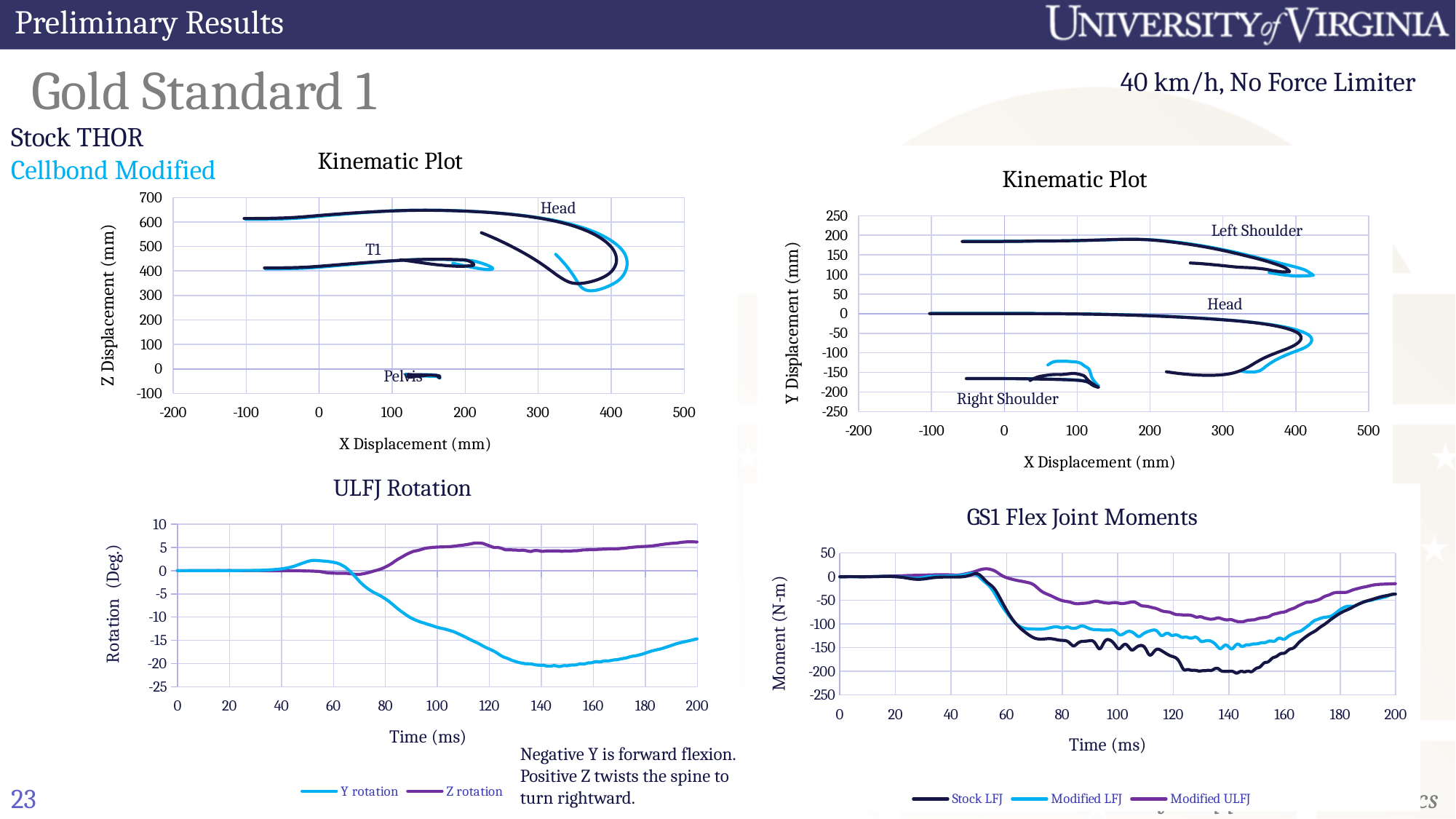
In the ULFJ Rotation chart, does the Y rotation series rise or fall between 80 ms and 140 ms? fall In the ULFJ Rotation chart, is the Y rotation value at 140 ms greater or less than -15? less How many series does the legend of the ULFJ Rotation chart list? 2 In the GS1 Flex Joint Moments chart, which series has the higher value at 140 ms, Modified ULFJ or Stock LFJ? Modified ULFJ What kind of chart is the ULFJ Rotation chart? line chart In the GS1 Flex Joint Moments chart, is the Modified ULFJ value at 100 ms greater or less than -100? greater In the GS1 Flex Joint Moments chart, does the Stock LFJ series rise or fall between 140 ms and 200 ms? rise What is the y-axis label of the GS1 Flex Joint Moments chart? Moment (N-m) How many charts are shown on the slide? 4 In the GS1 Flex Joint Moments chart, is the Stock LFJ value at 140 ms greater or less than -150? less What is the x-axis label of the top-left Kinematic Plot? X Displacement (mm) How many series does the legend of the GS1 Flex Joint Moments chart list? 3